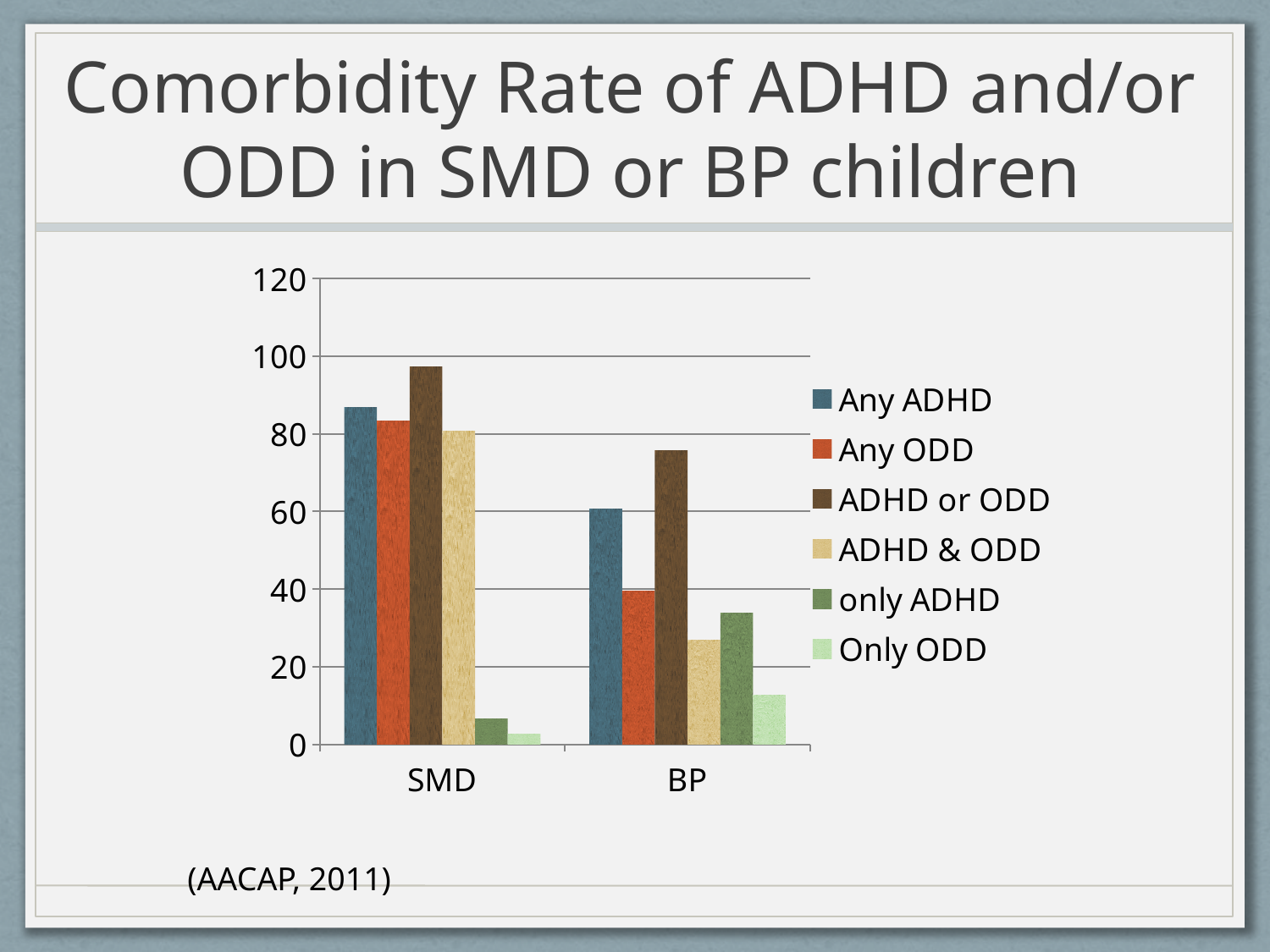
How many categories are shown on the x axis? 2 What is the title of the slide containing the chart? Comorbidity Rate of ADHD and/or ODD in SMD or BP children Which series has the highest value for BP? ADHD or ODD Which series has the lowest value for BP? Only ODD Which series has the highest value for SMD? ADHD or ODD What kind of chart is shown on the slide? bar chart Which series has the lowest value for SMD? Only ODD How many series does the legend list? 6 Which is larger, the only ADHD value for BP or the only ADHD value for SMD? BP Is the value for Any ADHD in SMD greater or less than 80? greater Which is larger, the Any ADHD value for SMD or the Any ADHD value for BP? SMD Is the value for Any ODD in BP greater or less than 60? less